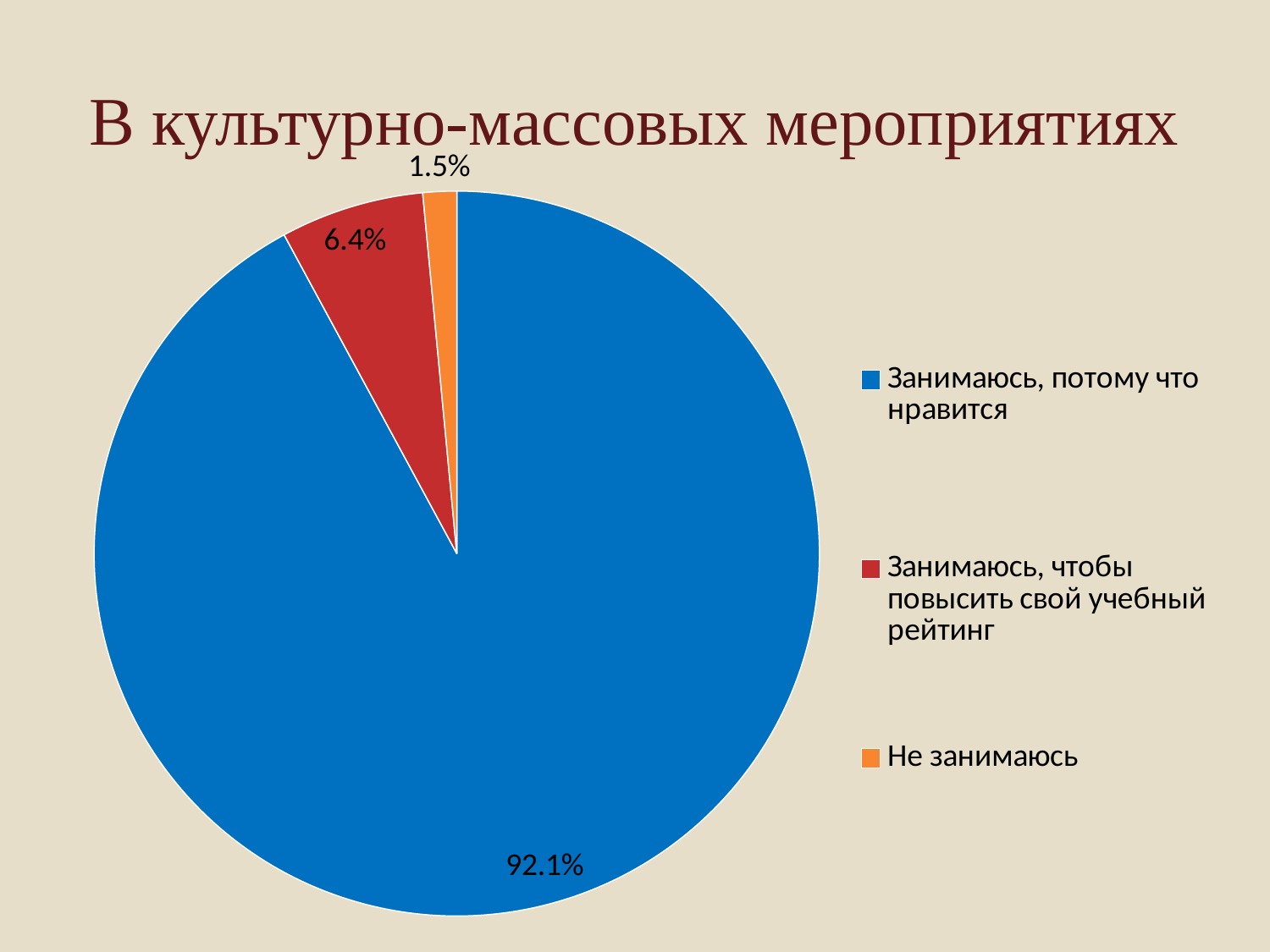
What kind of chart is shown on the slide? pie chart What share of the pie is labelled "Занимаюсь, чтобы повысить свой учебный рейтинг"? 6.4% What share of the pie is labelled "Не занимаюсь"? 1.5% What is the difference in percentage points between "Занимаюсь, чтобы повысить свой учебный рейтинг" and "Не занимаюсь"? 4.9 What colour is the slice for "Не занимаюсь"? orange Which category has the largest slice of the pie? Занимаюсь, потому что нравится Which is larger: the slice for "Занимаюсь, чтобы повысить свой учебный рейтинг" or the slice for "Не занимаюсь"? Занимаюсь, чтобы повысить свой учебный рейтинг What share of the pie is labelled "Занимаюсь, потому что нравится"? 92.1% What is the title of the slide? В культурно-массовых мероприятиях What is the difference in percentage points between "Занимаюсь, потому что нравится" and "Занимаюсь, чтобы повысить свой учебный рейтинг"? 85.7 How many categories does the pie chart have? 3 Which category has the smallest slice of the pie? Не занимаюсь